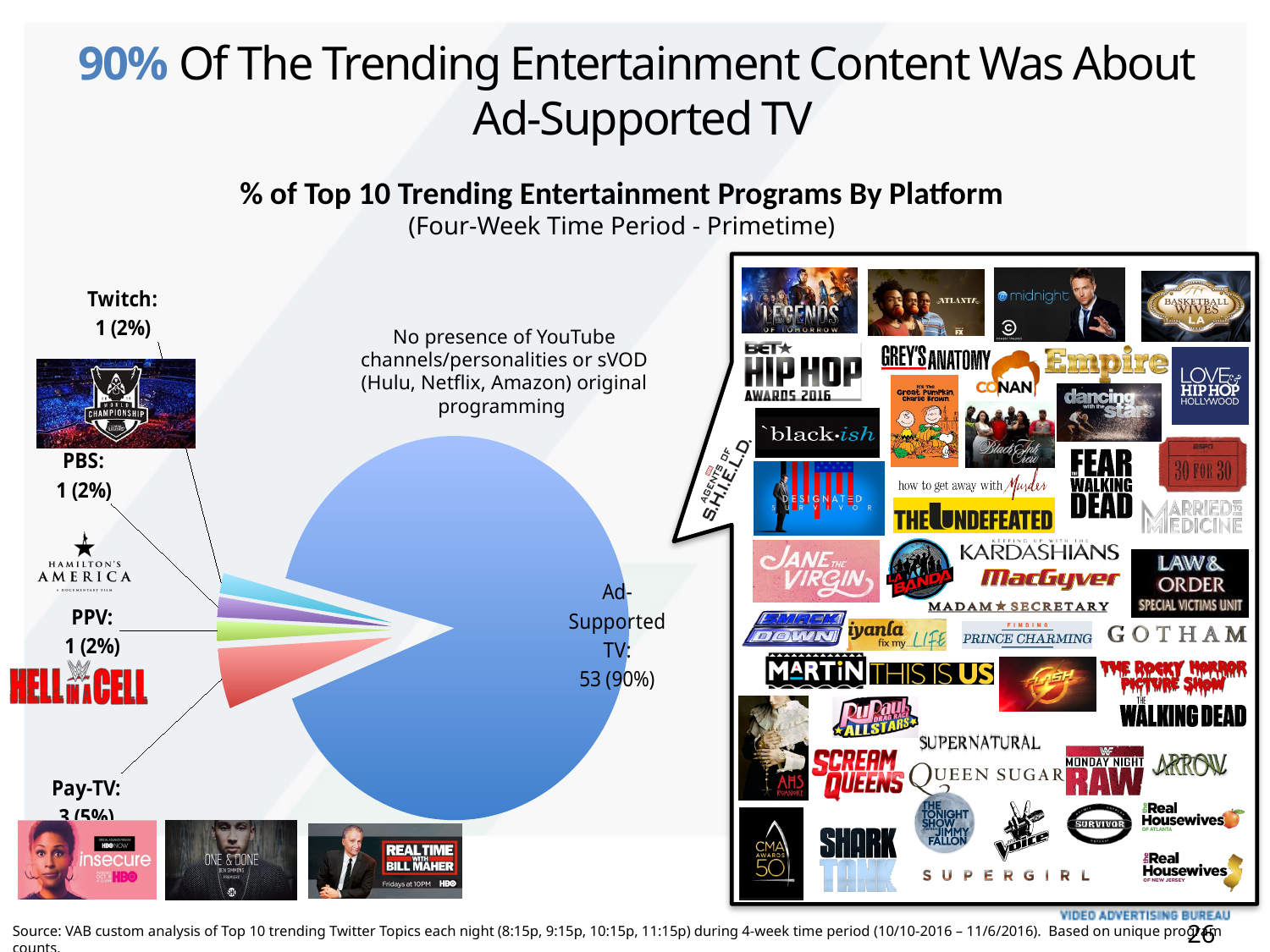
How many platform categories are shown in the pie chart? 5 What time period does the chart subtitle say the data covers? Four-Week Time Period - Primetime Which platform has a larger count, Pay-TV or PBS? Pay-TV How many programs are counted for Ad-Supported TV? 53 What share of the pie does Ad-Supported TV account for? 90% What percentage is shown for Twitch? 2% Which platform has the largest slice of the pie? Ad-Supported TV What kind of chart is shown on the slide? pie chart What is the title of the chart? % of Top 10 Trending Entertainment Programs By Platform What is the value shown for Pay-TV? 3 (5%) What is the difference in percentage points between Pay-TV and PPV? 3 What is the difference in program count between Ad-Supported TV and Pay-TV? 50